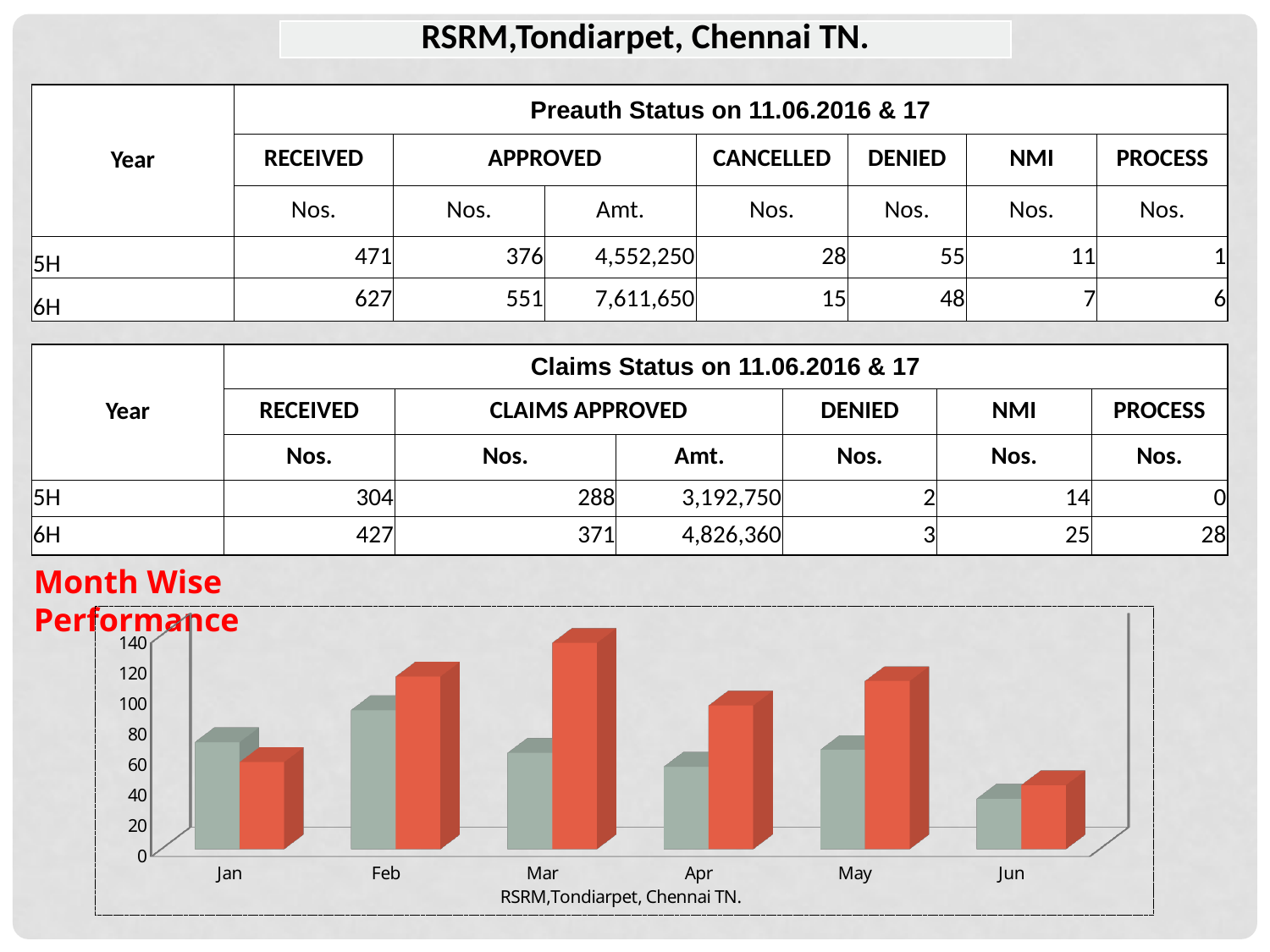
In the Month Wise Performance chart, which month has the shortest red bar? Jun In the Month Wise Performance chart, is the red bar for Feb greater or less than 100? greater What kind of chart is shown under the heading 'Month Wise Performance'? bar chart In the Month Wise Performance chart, which is larger for Mar: the grey bar or the red bar? the red bar How many months are shown on the x axis of the Month Wise Performance chart? 6 In the Month Wise Performance chart, which month has the tallest red bar? Mar In the Month Wise Performance chart, which month has the tallest grey bar? Feb In the Month Wise Performance chart, which month has the shortest grey bar? Jun In the Month Wise Performance chart, is the grey bar for Jun greater or less than 60? less What text appears as the title at the bottom of the Month Wise Performance chart? RSRM,Tondiarpet, Chennai TN. How many bars are plotted for each month in the Month Wise Performance chart? 2 In the Month Wise Performance chart, is the red bar for Mar greater or less than 120? greater